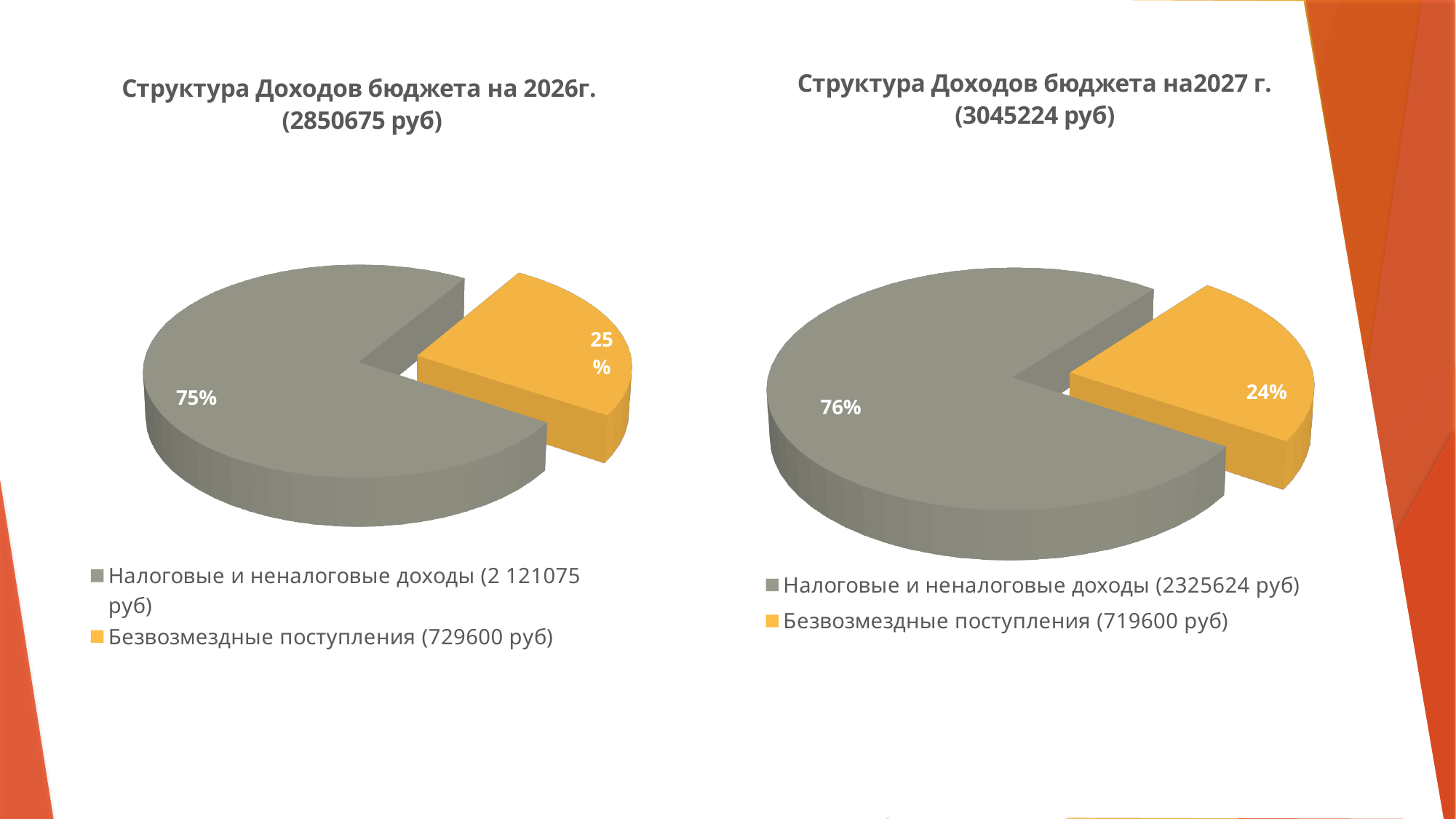
In the right chart (2027), which category has the smallest slice? Безвозмездные поступления In the left chart (2026), what is the difference in percentage points between the two slices? 50 How many slices does the chart titled "Структура Доходов бюджета на2027 г." have? 2 What total budget amount is shown in the title of the right chart (2027)? 3045224 руб What kind of chart is used on the left side of the slide? Pie chart In the chart titled "Структура Доходов бюджета на 2026г.", what share of the pie is "Налоговые и неналоговые доходы"? 75% In the left chart (2026), which slice is larger: "Налоговые и неналоговые доходы" or "Безвозмездные поступления"? Налоговые и неналоговые доходы In the chart titled "Структура Доходов бюджета на2027 г.", what share of the pie is "Налоговые и неналоговые доходы"? 76% In the chart titled "Структура Доходов бюджета на2027 г.", what share of the pie is "Безвозмездные поступления"? 24% In the left chart (2026), which category has the largest slice? Налоговые и неналоговые доходы In the right chart (2027), what is the difference in percentage points between the two slices? 52